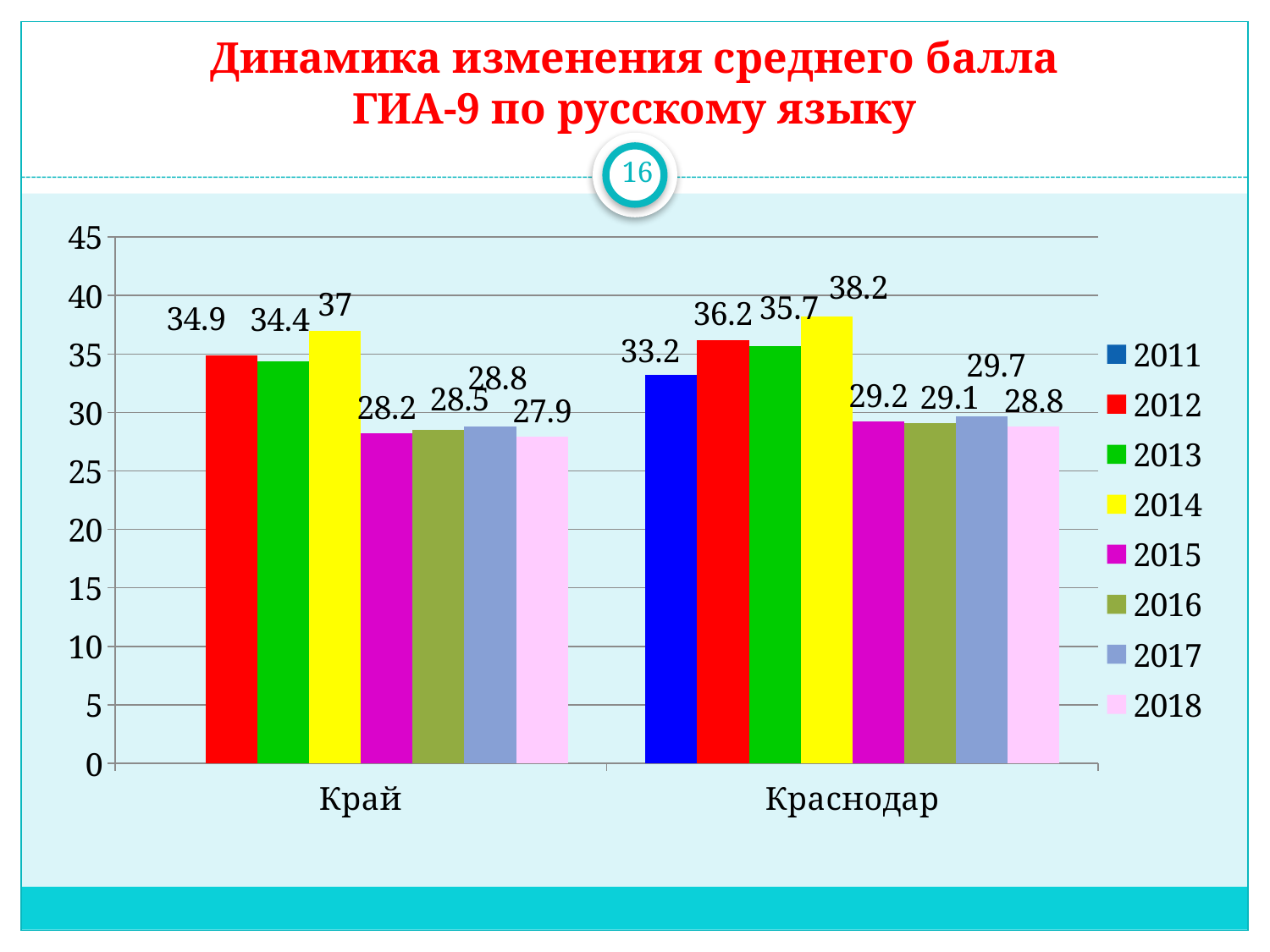
What is the difference between the 2014 values for Краснодар and Край? 1.2 Which is larger: the 2012 value for Край or the 2012 value for Краснодар? Краснодар What is the value for 2017 in the Краснодар group? 29.7 How many series does the legend list? 8 What is the value for 2018 in the Край group? 27.9 What kind of chart is shown on the slide? Bar chart Which year has the lowest value in the Край group? 2018 How many categories are shown on the x axis? 2 Which colour represents 2014 in the legend? Yellow What is the value for 2014 in the Край group? 37 Which year has the highest value in the Краснодар group? 2014 What is the value for 2011 in the Краснодар group? 33.2